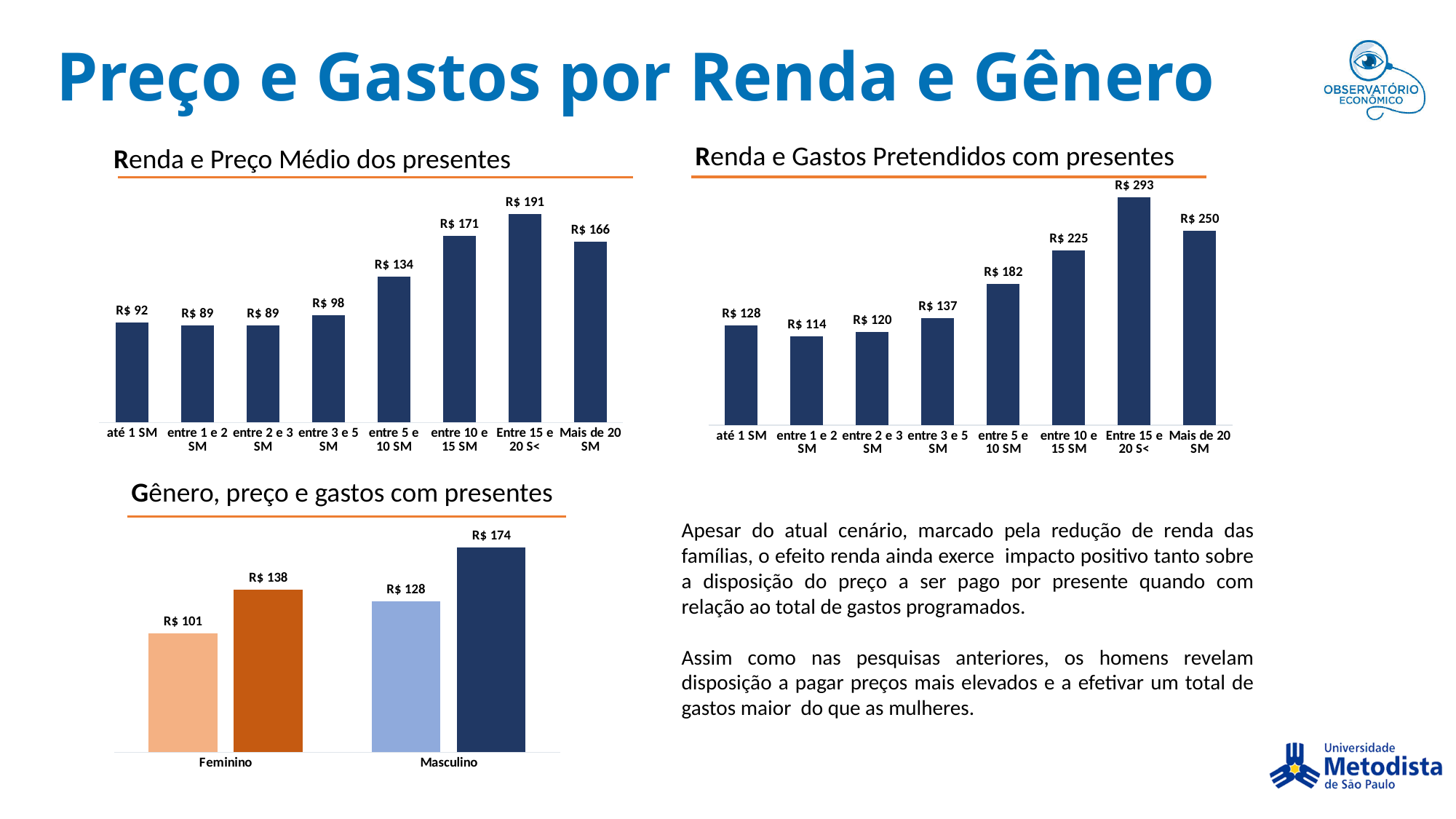
In the chart 'Renda e Gastos Pretendidos com presentes', what is the difference between 'Entre 15 e 20 S<' and 'entre 10 e 15 SM'? R$ 68 In the chart 'Gênero, preço e gastos com presentes', how many gender categories are shown on the x axis? 2 In the chart 'Renda e Preço Médio dos presentes', which income category has the highest value? Entre 15 e 20 S< In the chart 'Renda e Preço Médio dos presentes', how many income categories are shown? 8 In the chart 'Gênero, preço e gastos com presentes', what is the value of the tallest bar for 'Masculino'? R$ 174 In the chart 'Renda e Gastos Pretendidos com presentes', which is larger: 'entre 10 e 15 SM' or 'Mais de 20 SM'? Mais de 20 SM In the chart 'Renda e Gastos Pretendidos com presentes', which income category has the lowest value? entre 1 e 2 SM In the chart 'Gênero, preço e gastos com presentes', what is the value of the lowest bar for 'Feminino'? R$ 101 In the chart 'Renda e Preço Médio dos presentes', what is the value for 'entre 5 e 10 SM'? R$ 134 What type of chart is 'Renda e Gastos Pretendidos com presentes'? Bar chart In the chart 'Renda e Preço Médio dos presentes', what is the difference between 'Entre 15 e 20 S<' and 'Mais de 20 SM'? R$ 25 In the chart 'Renda e Gastos Pretendidos com presentes', what is the value for 'até 1 SM'? R$ 128